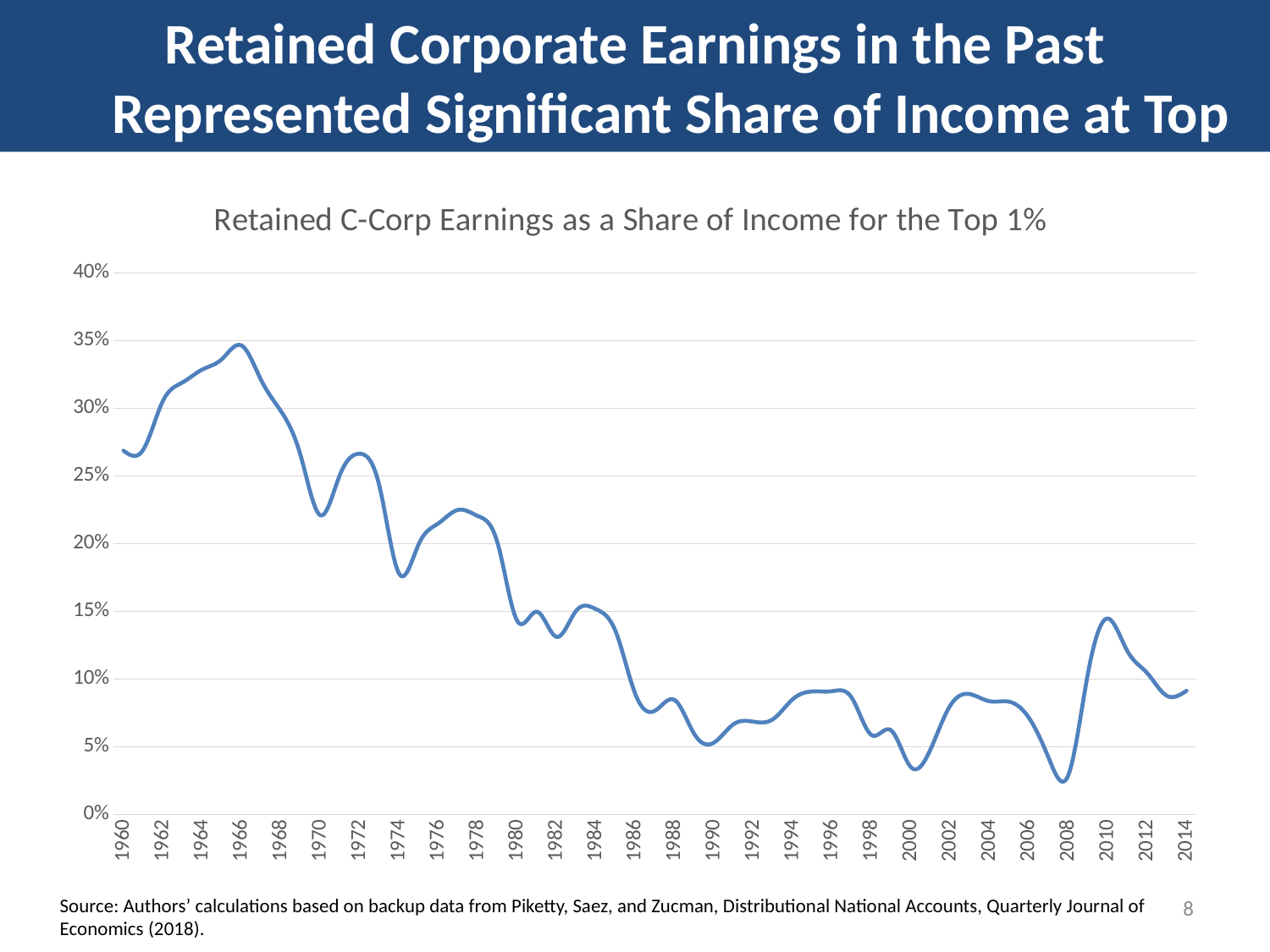
Is the value for 1966 greater or less than 30%? greater Is the value for 1974 greater or less than 20%? less Which year has the larger value, 1972 or 1984? 1972 Is the value for 1990 greater or less than 10%? less In which year does the line reach its highest value? 1966 What is the highest value shown on the vertical axis? 40% What is the title of the chart? Retained C-Corp Earnings as a Share of Income for the Top 1% Overall, does the share rise or fall from 1960 to 2014? fall What kind of chart is shown on the slide? line chart In which year does the line reach its lowest value? 2008